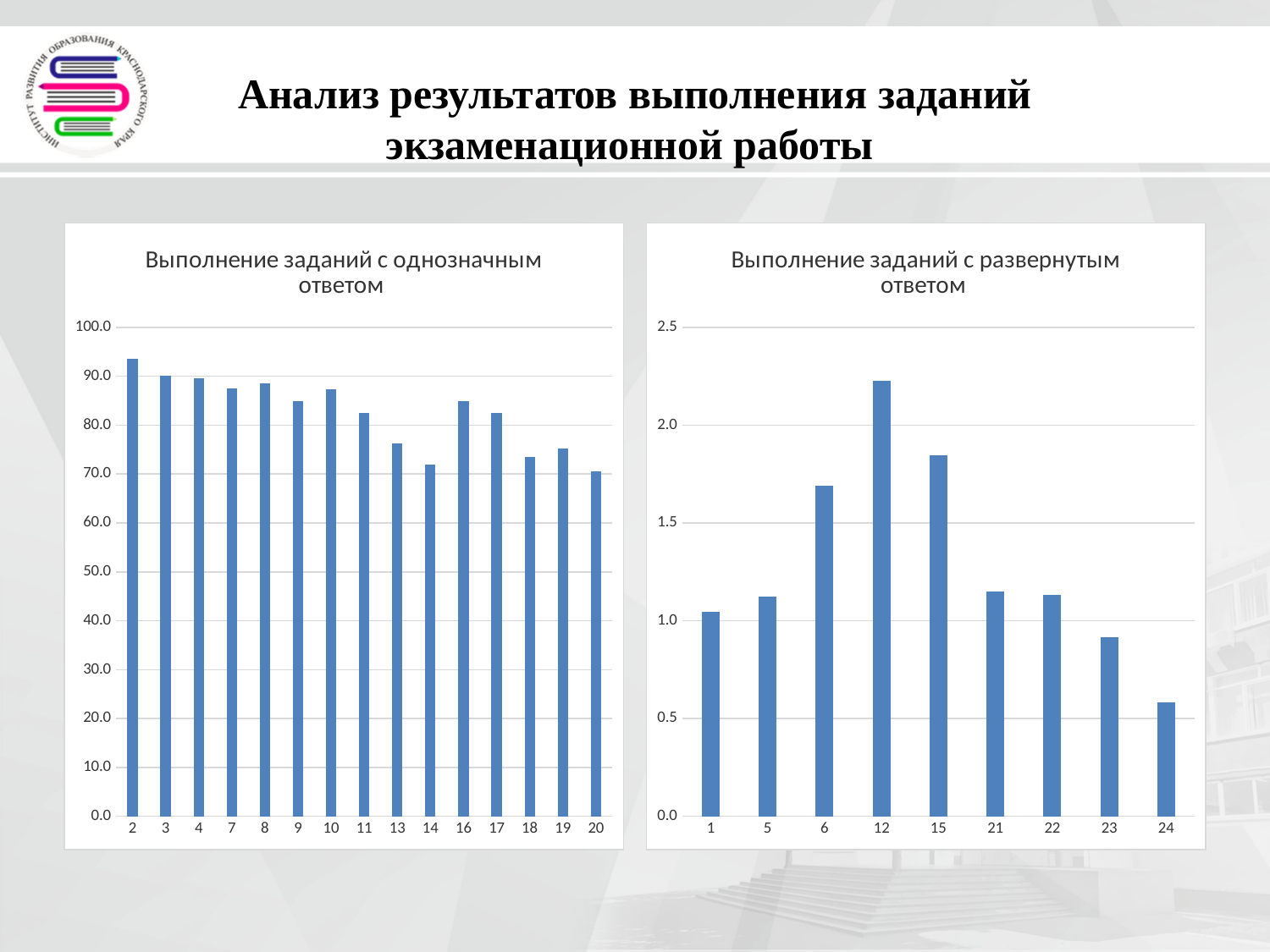
In the right chart, "Выполнение заданий с развернутым ответом", is the value for task 12 greater or less than 2.0? greater In the left chart, "Выполнение заданий с однозначным ответом", which task has the highest value? 2 In the right chart, "Выполнение заданий с развернутым ответом", which task has the highest value? 12 What kind of chart is the left chart, "Выполнение заданий с однозначным ответом"? bar chart In the right chart, "Выполнение заданий с развернутым ответом", which is larger, the value for task 6 or task 15? 15 In the left chart, "Выполнение заданий с однозначным ответом", how many task categories are shown on the x axis? 15 In the right chart, "Выполнение заданий с развернутым ответом", is the value for task 23 greater or less than 1.0? less In the right chart, "Выполнение заданий с развернутым ответом", which task has the lowest value? 24 In the right chart, "Выполнение заданий с развернутым ответом", how many task categories are shown on the x axis? 9 In the left chart, "Выполнение заданий с однозначным ответом", which task has the lowest value? 20 In the left chart, "Выполнение заданий с однозначным ответом", which is larger, the value for task 13 or task 14? 13 In the left chart, "Выполнение заданий с однозначным ответом", is the value for task 14 greater or less than 80.0? less